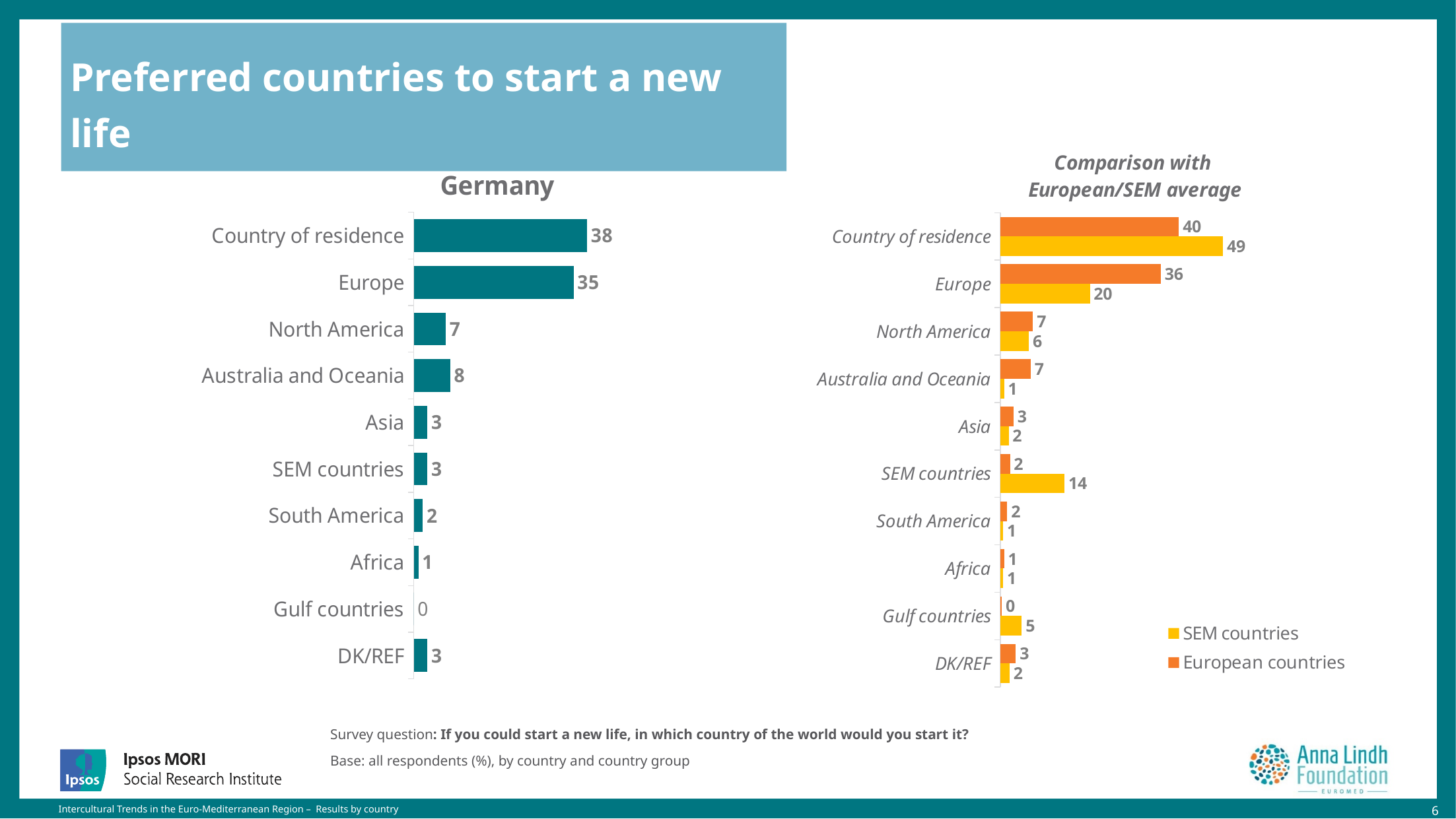
In the Germany chart, which is larger: North America or Australia and Oceania? Australia and Oceania In the Comparison with European/SEM average chart, what is the European countries value for Europe? 36 In the Germany chart, which category has the highest value? Country of residence In the Germany chart, which category has the lowest value? Gulf countries In the Germany chart, what is the value for Europe? 35 In the Comparison with European/SEM average chart, which colour represents SEM countries? Yellow In the Comparison with European/SEM average chart, what is the difference between the SEM countries and European countries values for SEM countries? 12 In the Germany chart, what is the difference between Country of residence and Europe? 3 How many series does the legend of the Comparison with European/SEM average chart list? 2 What type of chart is the Germany chart? Bar chart How many categories are shown in the Germany chart? 10 In the Comparison with European/SEM average chart, what is the SEM countries value for Country of residence? 49